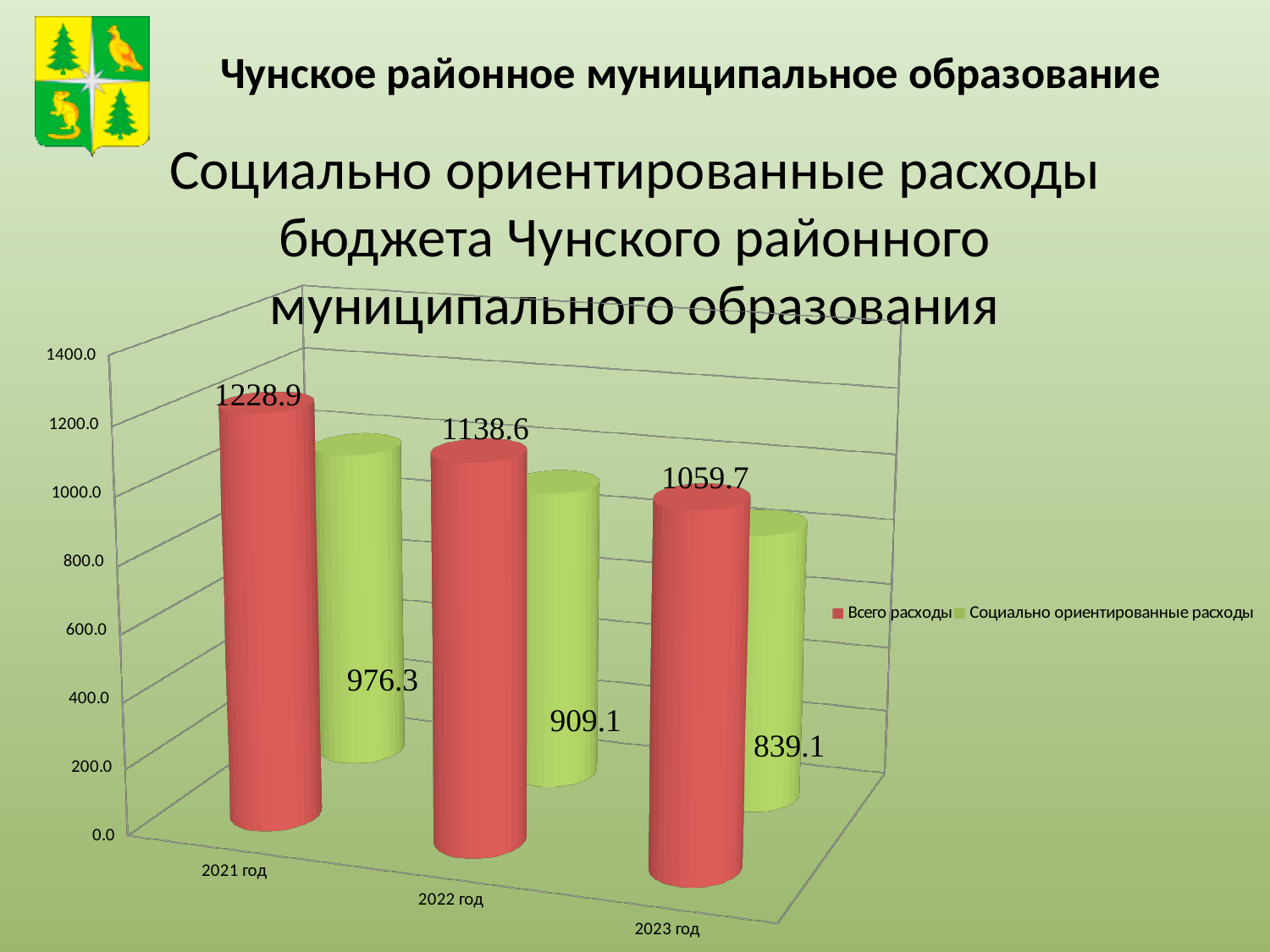
What kind of chart is shown on the slide? Bar chart In which year is Всего расходы the highest? 2021 год In which year is Социально ориентированные расходы the lowest? 2023 год What is the difference between Всего расходы and Социально ориентированные расходы in 2022 год? 229.5 Which is larger: Социально ориентированные расходы in 2021 год or Всего расходы in 2023 год? Всего расходы in 2023 год What is the value of Социально ориентированные расходы for 2023 год? 839.1 What is the value of Социально ориентированные расходы for 2022 год? 909.1 Do the values of Социально ориентированные расходы rise or fall from 2021 год to 2023 год? Fall How many years are shown on the x axis? 3 How many series does the legend list? 2 By how much did Всего расходы decrease from 2021 год to 2023 год? 169.2 What is the value of Всего расходы for 2021 год? 1228.9